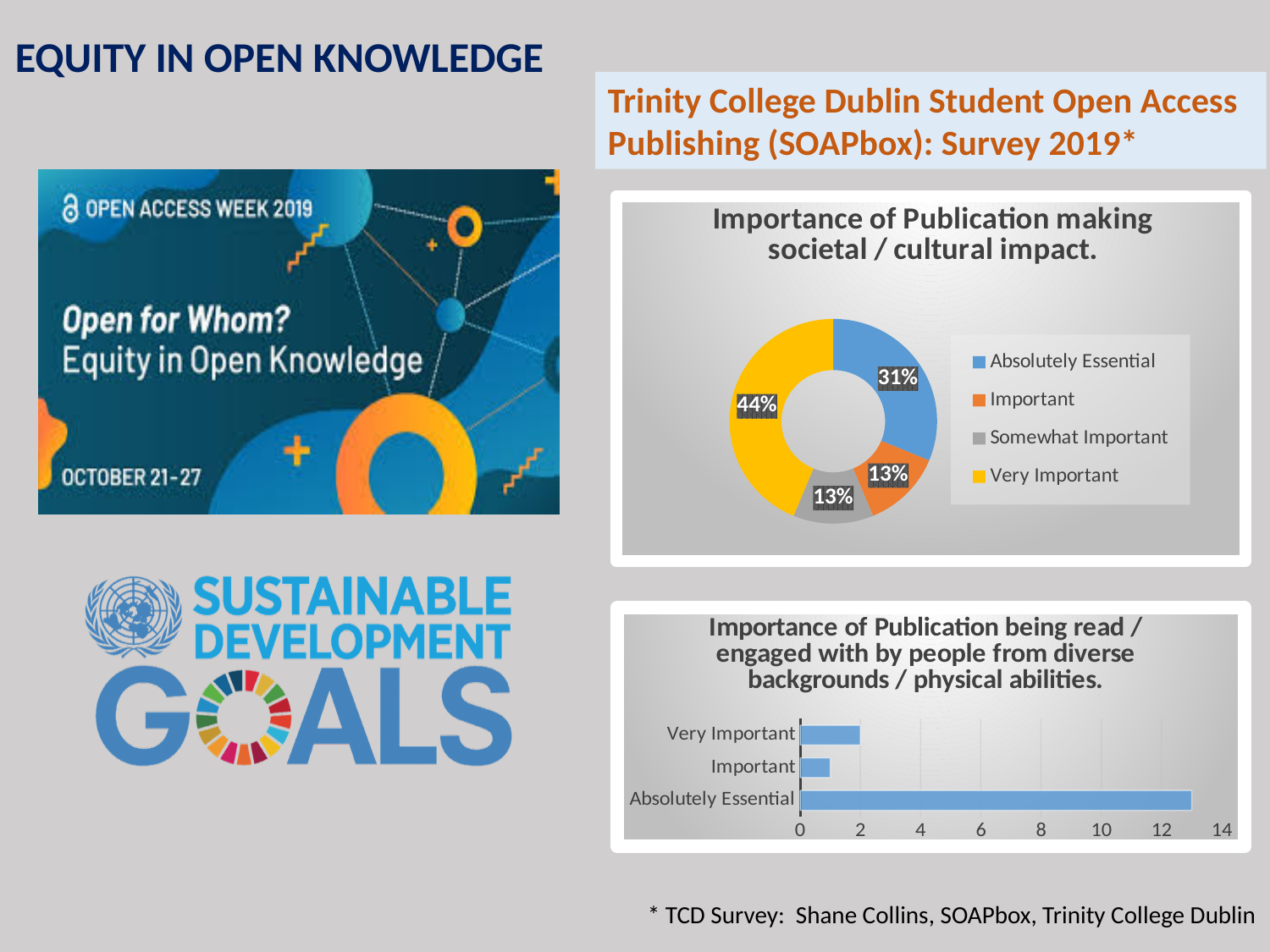
In the chart titled 'Importance of Publication making societal / cultural impact.', what is the difference between the Very Important and Absolutely Essential shares? 13% In the chart titled 'Importance of Publication making societal / cultural impact.', which category has the largest share? Very Important In the chart titled 'Importance of Publication being read / engaged with by people from diverse backgrounds / physical abilities.', how many categories are shown? 3 What kind of chart is the one titled 'Importance of Publication being read / engaged with by people from diverse backgrounds / physical abilities.'? Bar chart In the chart titled 'Importance of Publication making societal / cultural impact.', what share of responses is Very Important? 44% In the chart titled 'Importance of Publication making societal / cultural impact.', what share of responses is Somewhat Important? 13% What kind of chart is the one titled 'Importance of Publication making societal / cultural impact.'? Doughnut chart In the chart titled 'Importance of Publication being read / engaged with by people from diverse backgrounds / physical abilities.', is the value for Absolutely Essential greater or less than 12? greater In the chart titled 'Importance of Publication making societal / cultural impact.', which colour represents Important? Orange In the chart titled 'Importance of Publication being read / engaged with by people from diverse backgrounds / physical abilities.', which category has the highest value? Absolutely Essential In the chart titled 'Importance of Publication making societal / cultural impact.', how many categories does the legend list? 4 In the chart titled 'Importance of Publication making societal / cultural impact.', what share of responses is Absolutely Essential? 31%